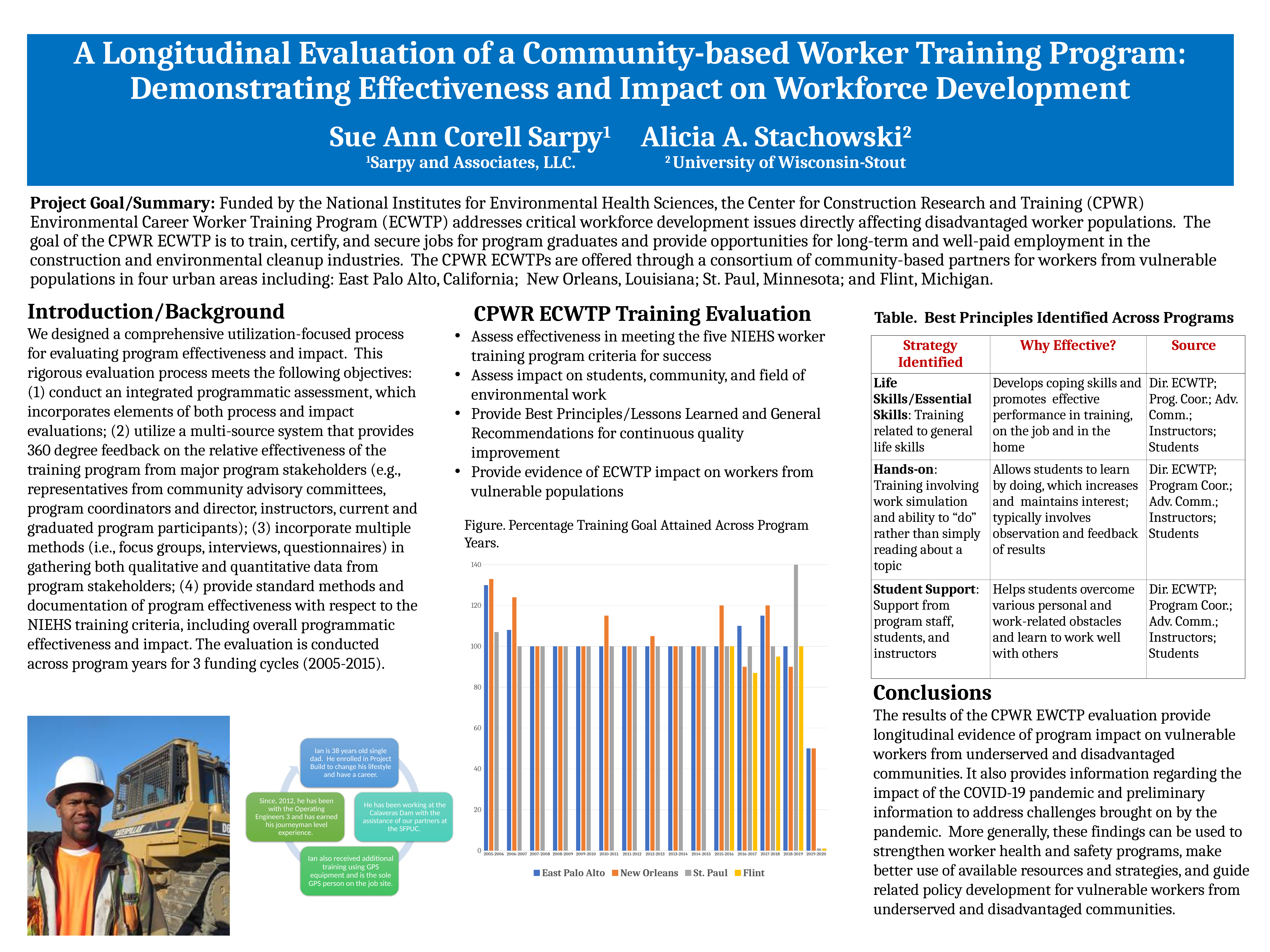
In the figure, is the value for East Palo Alto in 2019-2020 greater or less than 60? less In the figure, is the value for New Orleans in 2005-2006 greater or less than 120? greater Which series is shown in orange in the figure? New Orleans How many program-year categories are shown on the x axis of the figure? 15 In the figure, what is the value for East Palo Alto in 2007-2008? 100 In the figure, is the value for Flint in 2016-2017 greater or less than 100? less How many series does the legend of the figure list? 4 Which series is shown in yellow in the figure? Flint In the figure, which is larger for 2005-2006: New Orleans or St. Paul? New Orleans What kind of chart is the figure titled "Percentage Training Goal Attained Across Program Years"? bar chart In the figure, which program has the highest value for 2018-2019? St. Paul